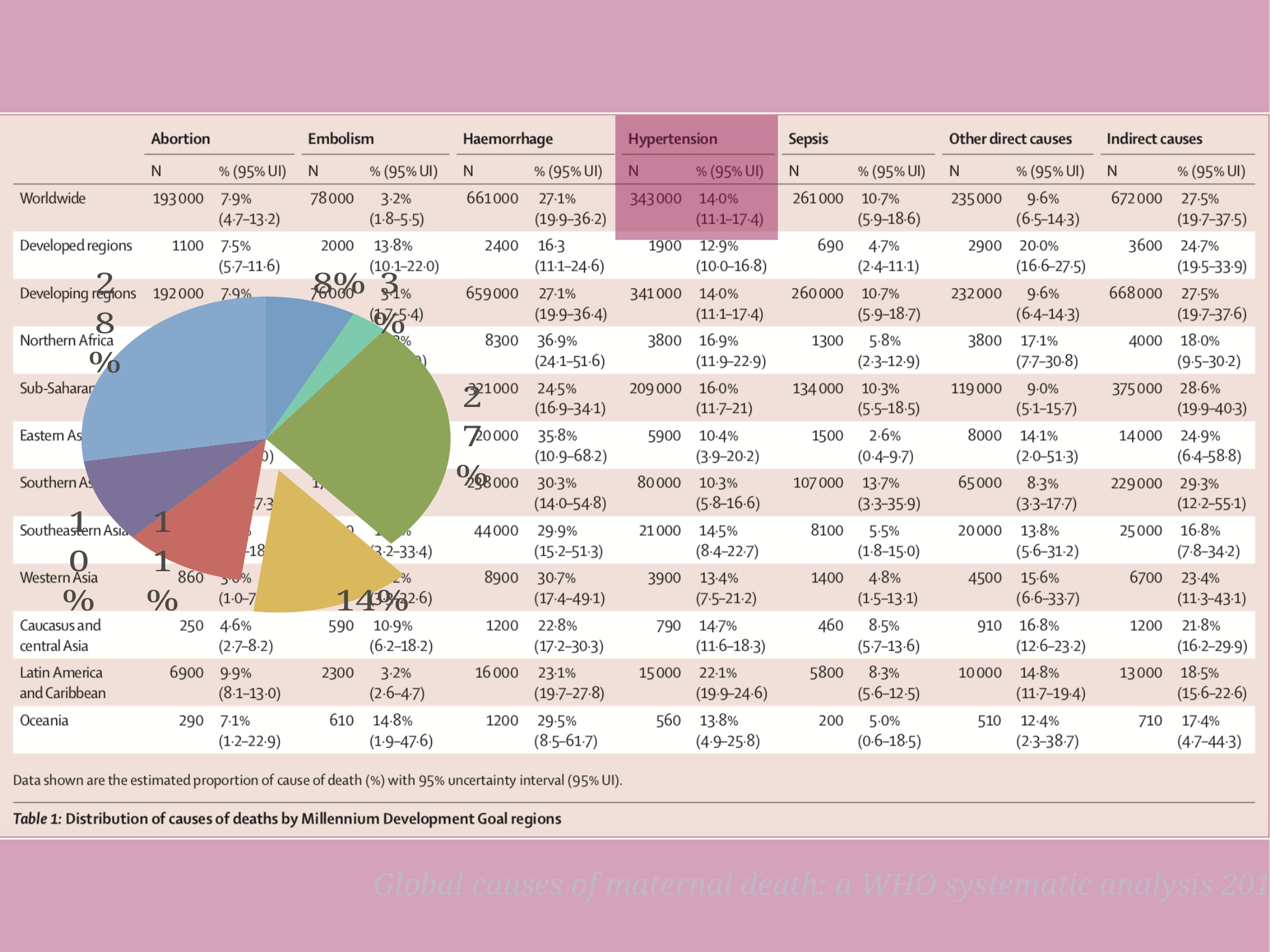
What kind of chart is overlaid on the table on this slide? Pie chart What colour is the slice that is pulled out from the pie chart? Yellow What percentage label is shown on the exploded (pulled-out) yellow slice of the pie chart? 14% Does the pie chart on the slide have a legend? No What percentage label is shown on the large green slice of the pie chart? 27% What is the smallest percentage label shown on the pie chart? 3% Which slice of the pie chart is larger, the green slice or the yellow slice? The green slice How many slices does the pie chart have? 7 What is the difference between the green slice's label (27%) and the yellow slice's label (14%) on the pie chart? 13 percentage points